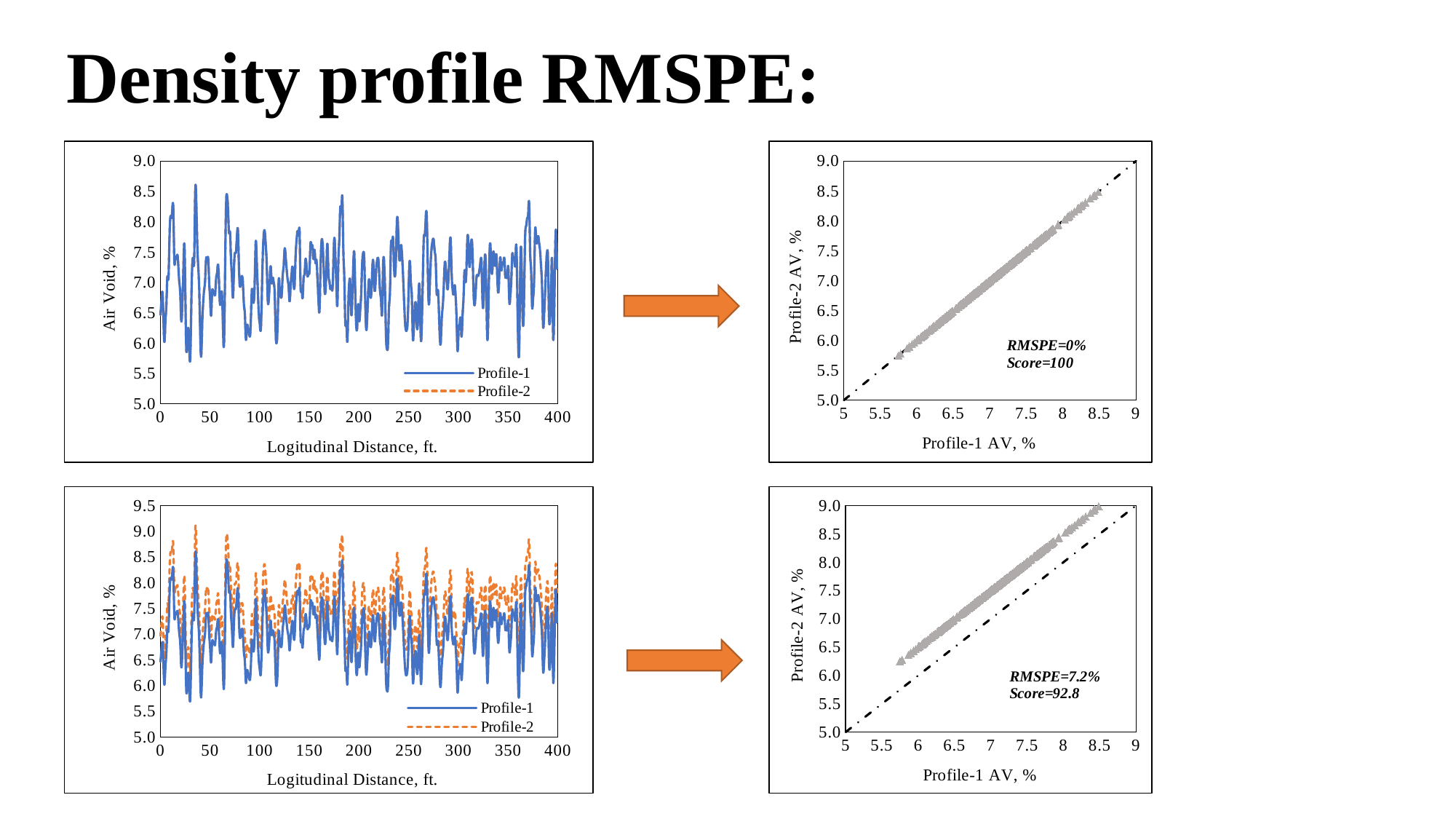
In the bottom-left chart, which series generally has the higher values, Profile-1 or Profile-2? Profile-2 What kind of chart is the top-right chart on the slide? scatter chart How many series does the legend of the bottom-left chart list? 2 Which scatter chart shows the higher RMSPE, the top-right or the bottom-right? bottom-right What is the x-axis title of the bottom-left chart? Logitudinal Distance, ft. In the top-left chart, is the highest value of Profile-1 greater or less than 9.0? less In the bottom-right chart, what Score value is printed? Score=92.8 In the bottom-right chart, do the plotted points rise or fall as Profile-1 AV increases along the x axis? rise What kind of chart is the top-left chart on the slide? line chart In the bottom-right chart, what RMSPE value is printed? RMSPE=7.2% In the top-right chart, what RMSPE value is printed? RMSPE=0% What is the difference between the Score printed on the top-right chart and the Score printed on the bottom-right chart? 7.2